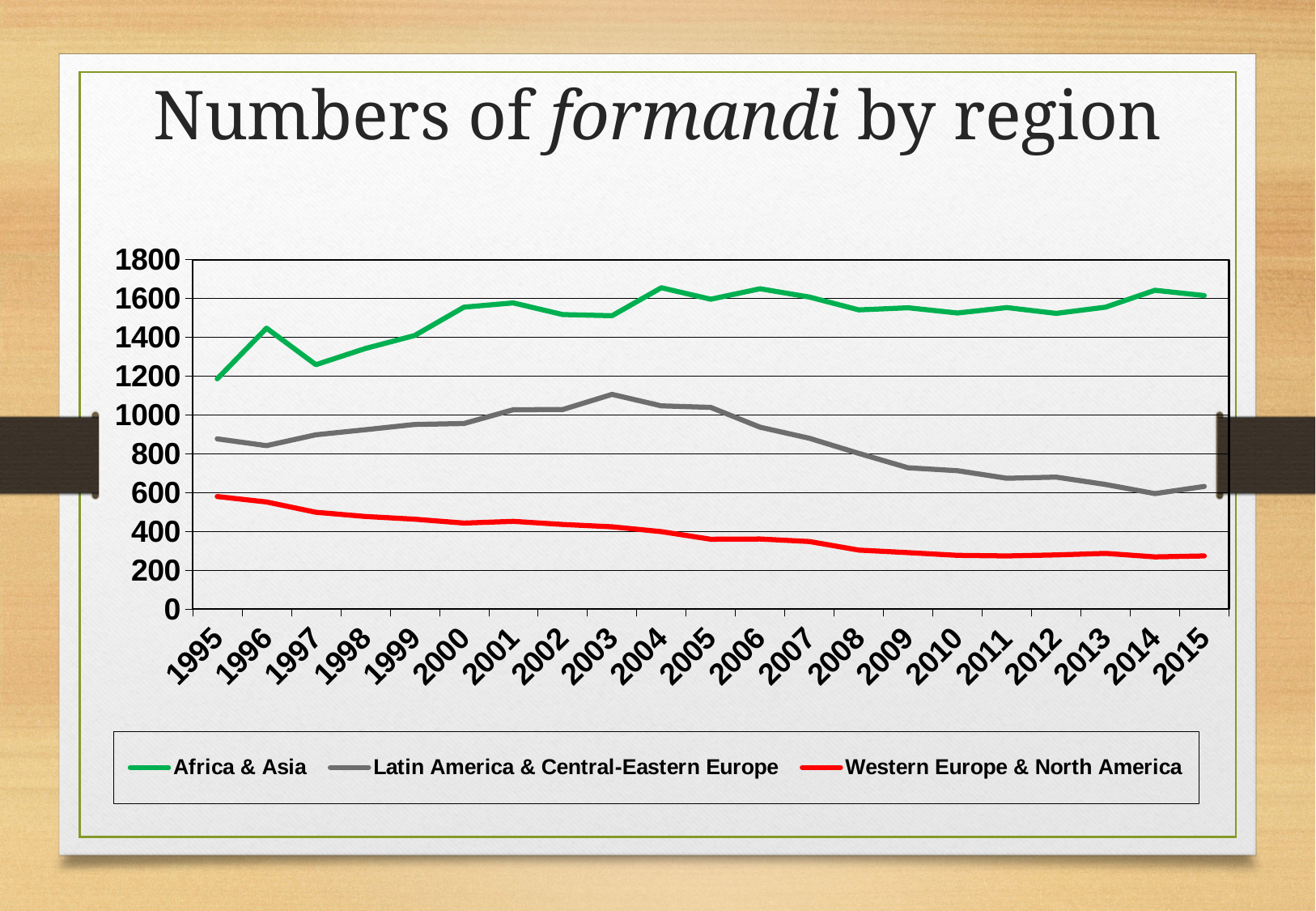
Which region has the highest number of formandi in 2010? Africa & Asia What colour is the line for Africa & Asia? green Does the Western Europe & North America line generally rise or fall from 1995 to 2015? fall What kind of chart is shown on the slide? line chart How many series does the legend list? 3 Is the value for Latin America & Central-Eastern Europe in 2003 greater or less than 1000? greater Is the value for Latin America & Central-Eastern Europe in 2014 greater or less than 800? less Is the value for Western Europe & North America in 2015 greater or less than 400? less How many years are plotted along the x axis? 21 In 2015, which is larger: the value for Africa & Asia or the value for Latin America & Central-Eastern Europe? Africa & Asia Which region has the lowest number of formandi in 2000? Western Europe & North America